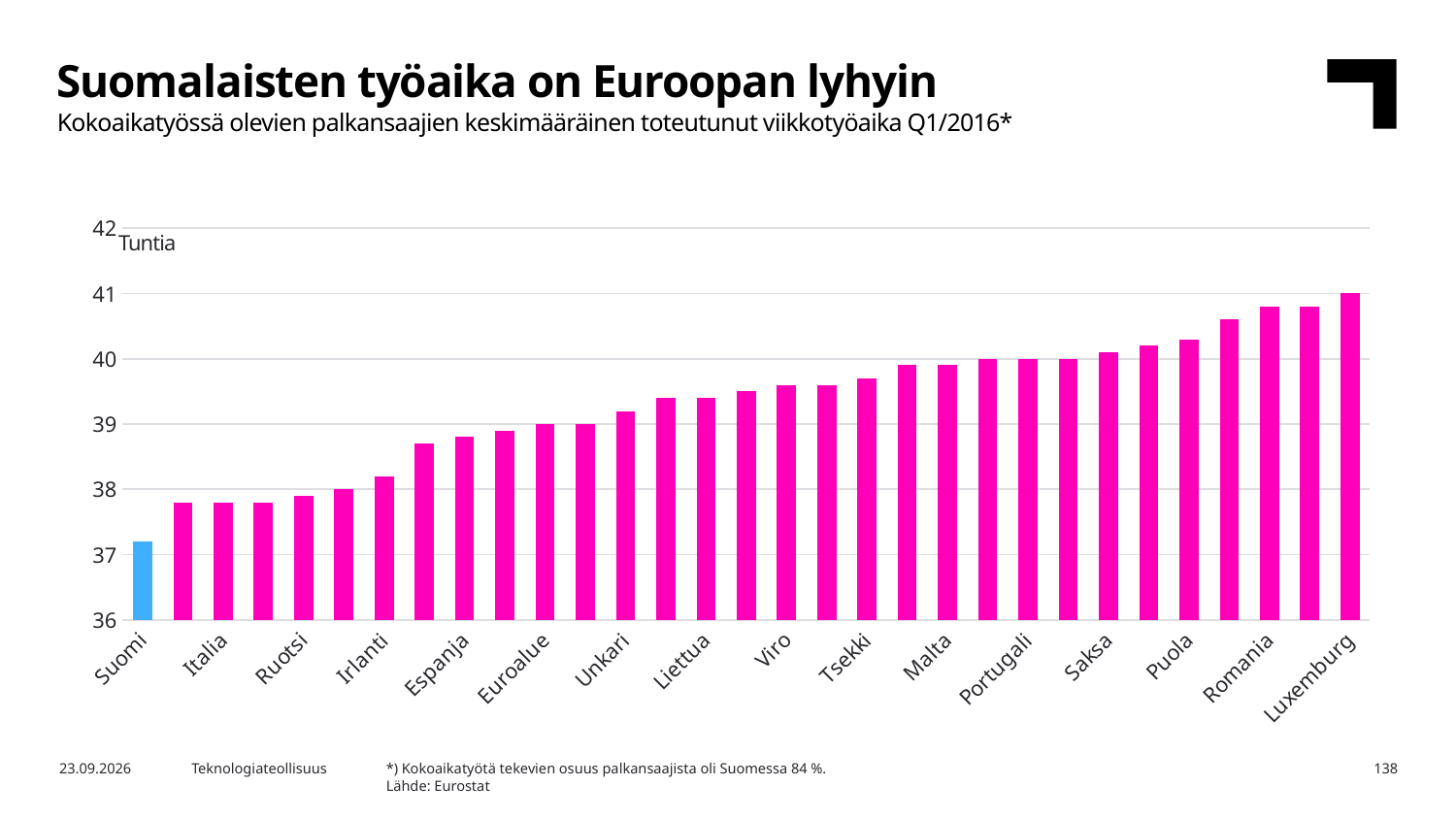
What is the value for Luxemburg? 41 What is the value for Euroalue? 39 Which is larger, the value for Italia or the value for Romania? Romania Which country's bar is shown in a different colour (blue) from the others? Suomi Which country has the lowest average weekly working time in the chart? Suomi Is the value for Viro greater or less than 40? less Do the values rise or fall from left to right along the x axis? rise Which country has the highest average weekly working time in the chart? Luxemburg Is the value for Espanja greater or less than 39? less Is the value for Puola greater or less than 40? greater What kind of chart is shown on the slide? bar chart